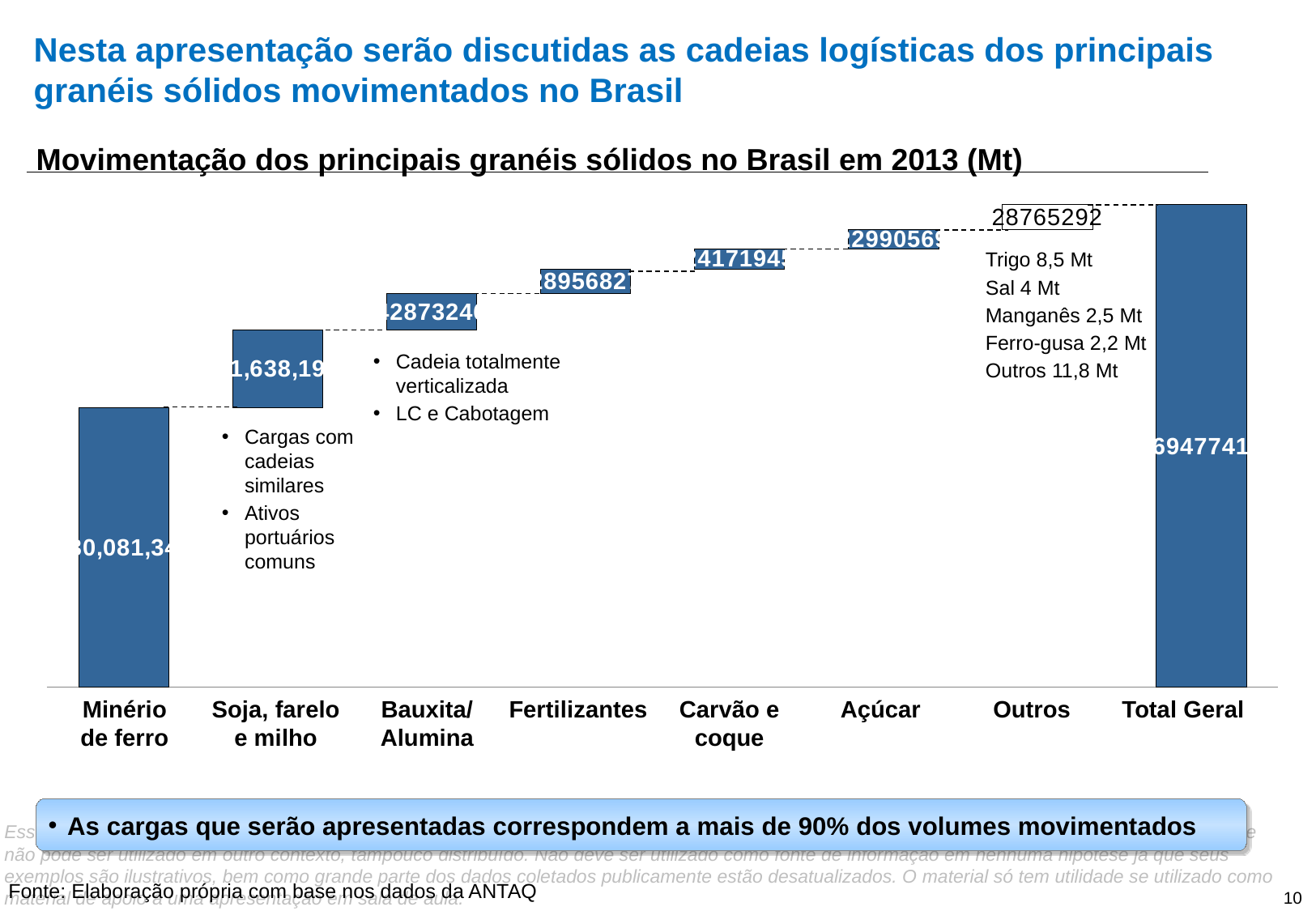
According to the annotation next to the Outros bar, how many Mt of Trigo are included? 8,5 Mt How many categories are shown along the x axis of the chart? 8 What kind of chart is shown on the slide? Bar chart (waterfall) Excluding Total Geral, which cargo category has the largest bar? Minério de ferro What is the title of the chart? Movimentação dos principais granéis sólidos no Brasil em 2013 (Mt) What is the data label shown for the Outros bar? 28765292 Which category has the smallest bar in the chart? Açúcar Which category has the tallest bar in the chart? Total Geral Which bar is larger: Minério de ferro or Soja, farelo e milho? Minério de ferro Which category is listed last on the x axis? Total Geral Which bar is larger: Bauxita/Alumina or Açúcar? Bauxita/Alumina